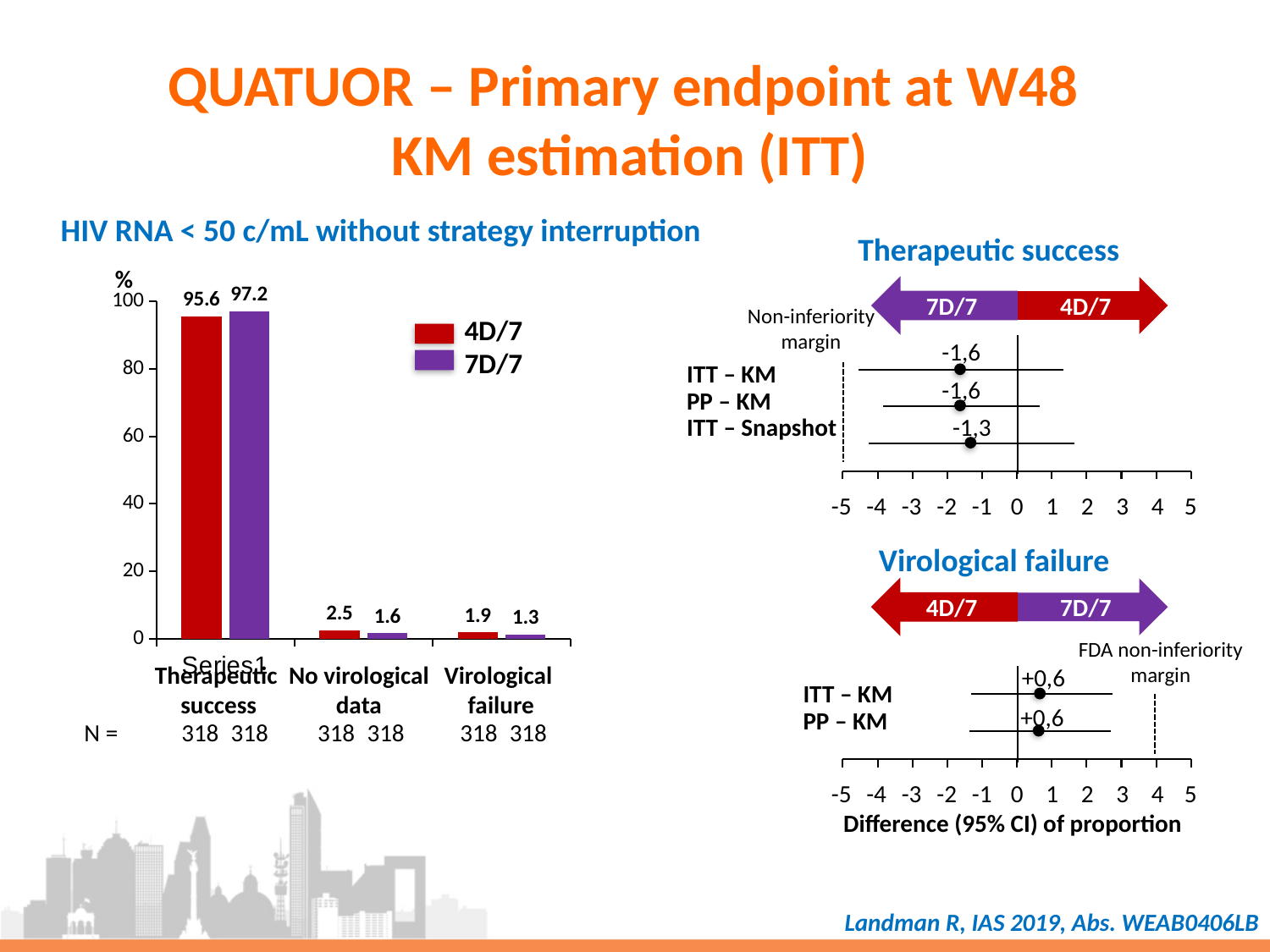
In the bar chart on the left, what is the value for 7D/7 for Therapeutic success? 97.2 In the Therapeutic success forest plot on the right, what is the point estimate for ITT – Snapshot? -1,3 In the bar chart on the left, what is the value for 7D/7 for Virological failure? 1.3 In the bar chart on the left, how many series does the legend list? 2 In the bar chart on the left, what is the difference between the 7D/7 and 4D/7 values for Therapeutic success? 1.6 In the bar chart on the left, which arm has the higher value for Virological failure, 4D/7 or 7D/7? 4D/7 In the bar chart on the left, what is the value for 4D/7 for No virological data? 2.5 In the bar chart on the left, which category has the highest values? Therapeutic success In the bar chart on the left, how many categories are shown on the x axis? 3 In the bar chart on the left, what is the value for 4D/7 for Therapeutic success? 95.6 In the Virological failure forest plot on the right, what is the point estimate for ITT – KM? +0,6 What kind of chart is the chart on the left of the slide? Bar chart